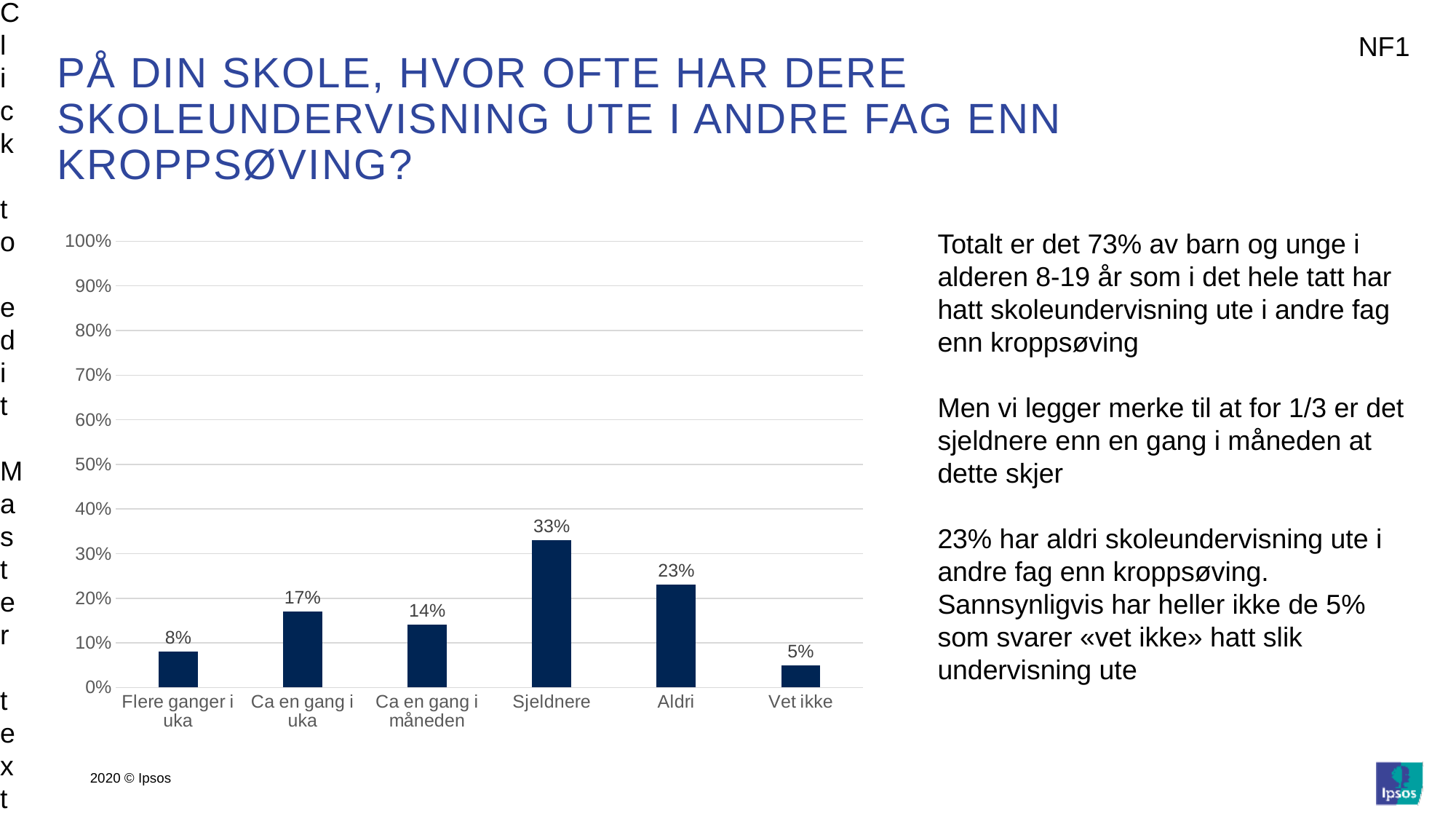
What is the difference between the values for "Sjeldnere" and "Aldri"? 10% What is the value for "Ca en gang i måneden"? 14% What is the value for "Flere ganger i uka"? 8% What is the value for "Vet ikke"? 5% What is the value for "Sjeldnere"? 33% Which category has the highest value? Sjeldnere Which is larger, the value for "Ca en gang i uka" or the value for "Ca en gang i måneden"? Ca en gang i uka Which category has the lowest value? Vet ikke What is the highest value shown on the y axis? 100% How many categories are shown on the x axis? 6 What kind of chart is shown on the slide? bar chart Is the value for "Aldri" greater or less than 20%? greater